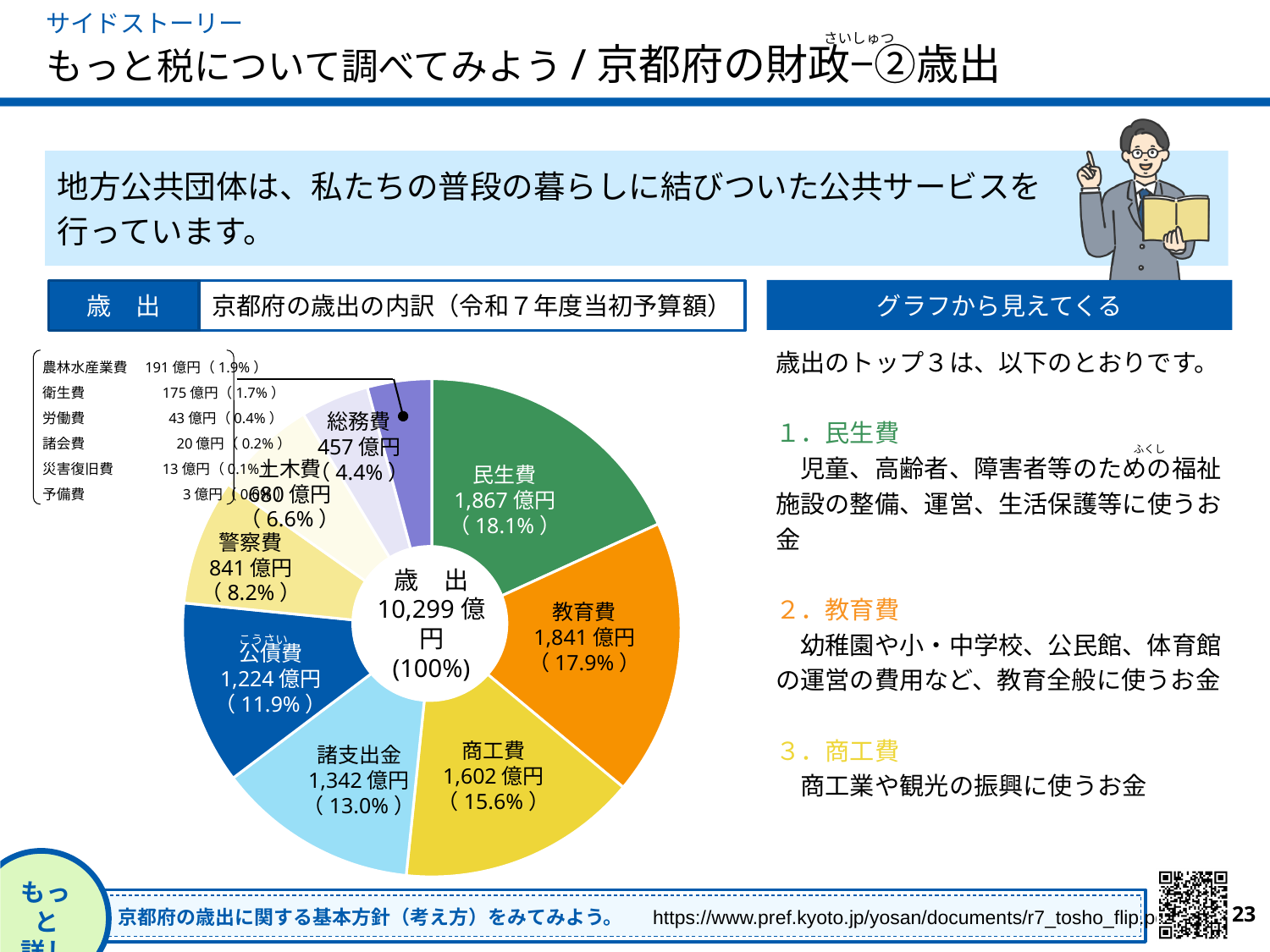
このグラフのタイトルは何ですか。 京都府の歳出の内訳（令和７年度当初予算額） 円グラフで、教育費の割合は何％ですか。 17.9% 円グラフで、商工費の金額はいくらですか。 1,602 億円 円グラフで、最も金額が大きい費目はどれですか。 民生費 このスライドのグラフはどの種類のグラフですか。 円グラフ 円グラフで、民生費と教育費の金額の差はいくらですか。 26 億円 円グラフで、公債費の割合は何％ですか。 11.9% 円グラフで、諸支出金と公債費では、どちらの金額が大きいですか。 諸支出金 円グラフで、警察費の割合は何％ですか。 8.2% 円グラフで、民生費の金額はいくらですか。 1,867 億円 円グラフの中央に示されている歳出の合計額はいくらですか。 10,299 億円 円グラフで、最も金額が小さい費目はどれですか。 予備費